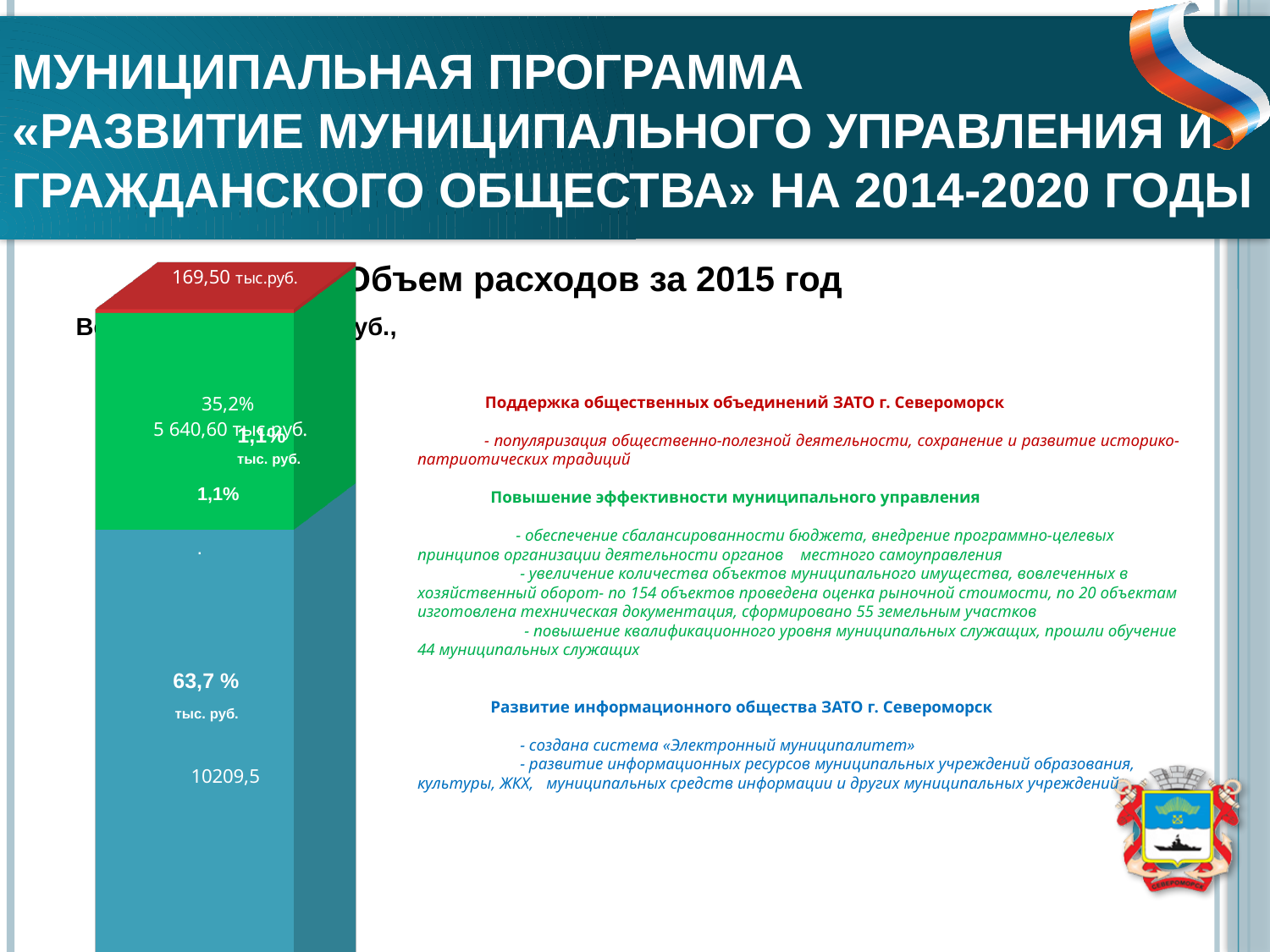
Which segment of the stacked bar is the smallest? the red top segment (169,50 тыс.руб.) How many segments make up the stacked bar on the slide? 3 What kind of chart is shown on the slide? stacked bar chart By how many percentage points does the blue segment's share exceed the green segment's share? 28,5 Which segment of the stacked bar is the largest? the blue bottom segment (63,7 %) Which is larger, the blue segment's share or the green segment's share? the blue segment (63,7 %) What percentage is printed on the blue bottom segment of the bar? 63,7 % What percentage is printed on the green middle segment of the bar? 35,2% What value in тыс. руб. is printed on the blue bottom segment of the bar? 10209,5 What value is printed on the green middle segment of the bar? 5 640,60 тыс.руб. What value is printed on the red top segment of the bar? 169,50 тыс.руб. What is the title of the chart on the slide? Объем расходов за 2015 год